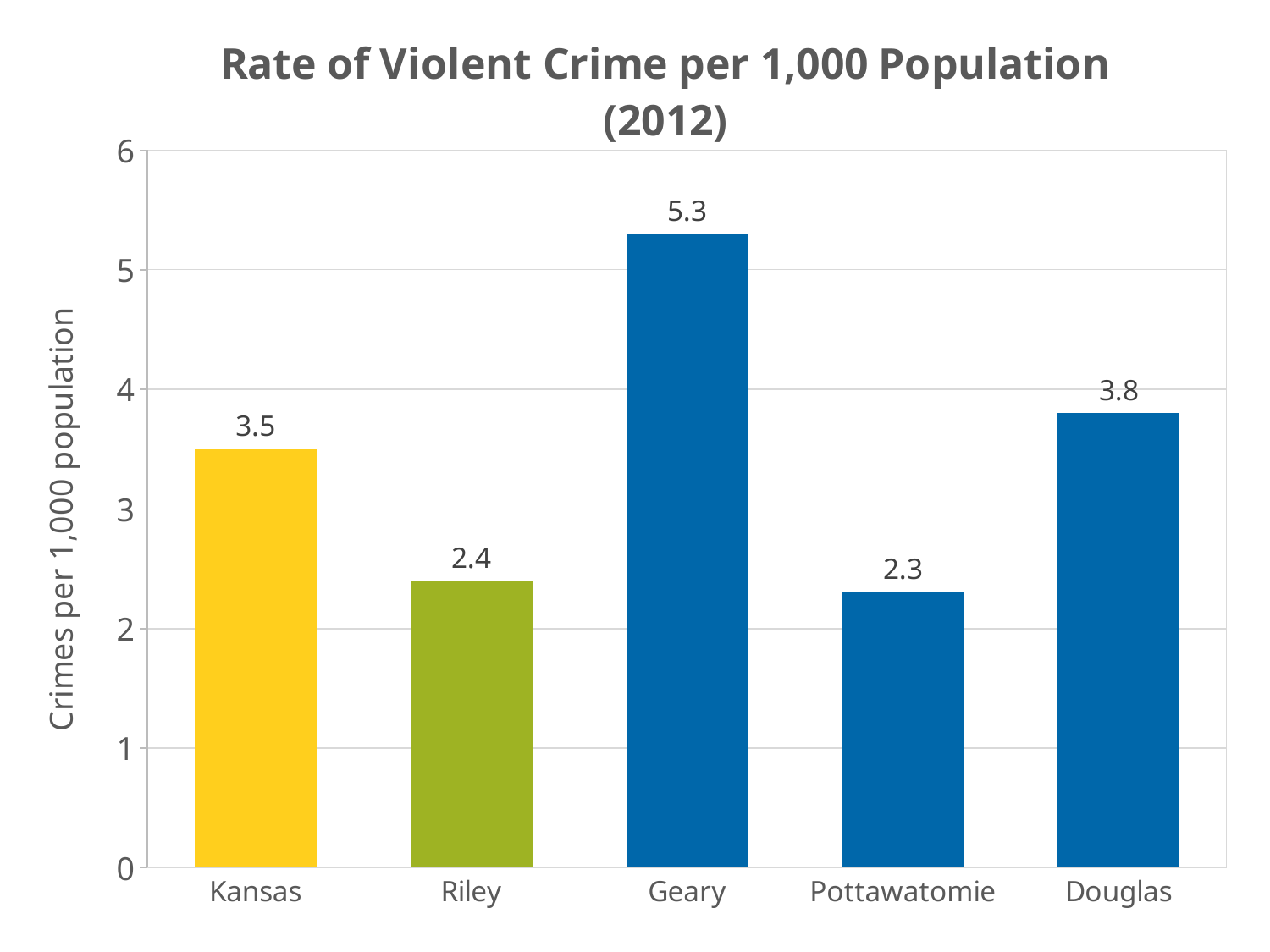
Which category has the highest rate of violent crime? Geary What kind of chart is shown on the slide? Bar chart What is the value shown for Pottawatomie? 2.3 What is the difference between the values for Geary and Riley? 2.9 How many categories are shown on the x axis? 5 What is the rate of violent crime per 1,000 population for Kansas? 3.5 Which category has the lowest rate of violent crime? Pottawatomie Is the value for Riley greater or less than 3? less Which has a higher value, Kansas or Douglas? Douglas What is the value shown for Geary? 5.3 What is the value shown for Douglas? 3.8 What is the title of the chart? Rate of Violent Crime per 1,000 Population (2012)